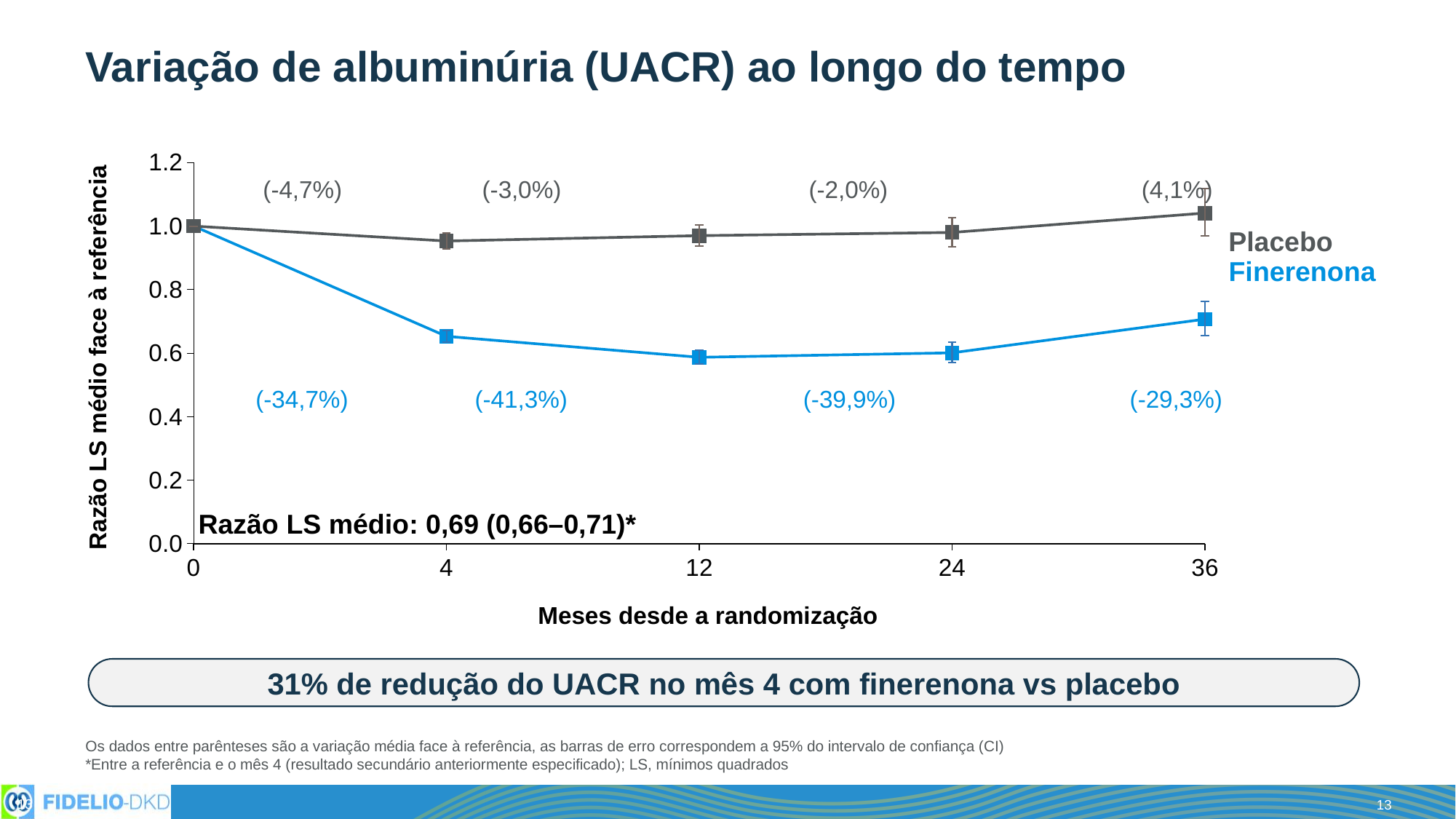
Is the value for Finerenona at month 12 greater or less than 0.8? less What kind of chart is shown on the slide? line chart What percentage change from baseline is labelled for Finerenona at month 4? -34,7% What is the plotted value for both Placebo and Finerenona at month 0? 1.0 What percentage change from baseline is labelled for Finerenona at month 12? -41,3% Is the value for Placebo at month 24 greater or less than 0.8? greater How many time points are plotted along the x axis? 5 At month 36, which series has the higher ratio, Placebo or Finerenona? Placebo What is the title of the x axis? Meses desde a randomização Does the Finerenona line rise or fall between month 0 and month 12? fall What percentage change from baseline is labelled for Placebo at month 36? 4,1% How many series does the chart show? 2